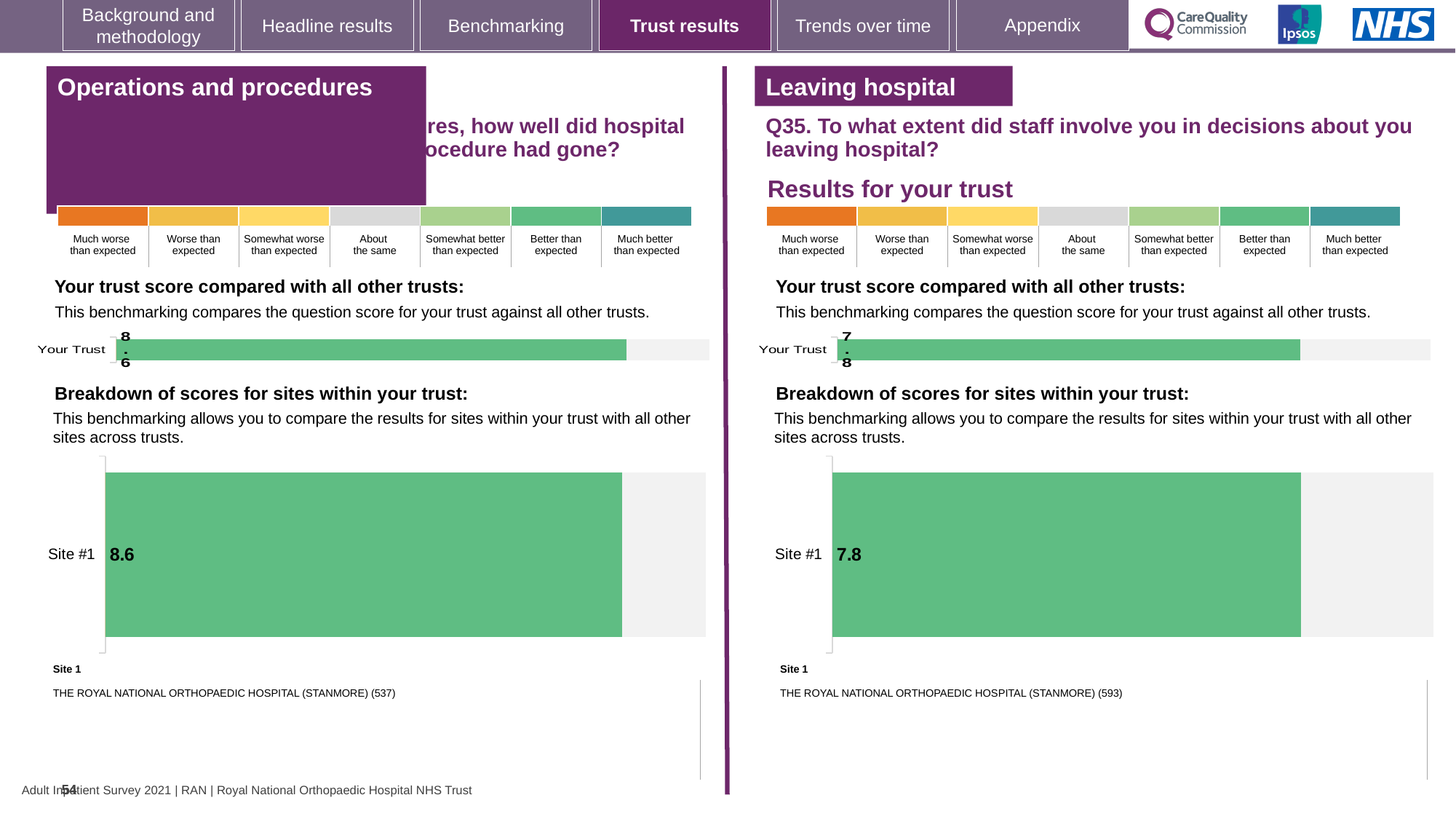
What is the difference between the Site #1 score in the Operations and procedures section and the Site #1 score in the Leaving hospital section? 0.8 What colour is the Site #1 bar in the Leaving hospital section's breakdown chart? Green In the Leaving hospital section, what is the name of Site 1 listed below the breakdown chart? THE ROYAL NATIONAL ORTHOPAEDIC HOSPITAL (STANMORE) Which Site #1 score is larger: the one in the Operations and procedures section or the one in the Leaving hospital section? Operations and procedures What kind of chart is used to show the Site #1 score in the Leaving hospital section? Bar chart How many sites are shown in the breakdown of scores chart in the Operations and procedures section? 1 In the Operations and procedures section, what is the score shown for Site #1 in the breakdown of scores for sites chart? 8.6 In the Leaving hospital section (Q35), what is the score shown for Site #1 in the breakdown of scores for sites chart? 7.8 In the Operations and procedures section, what is the value shown for Your Trust in the trust score chart? 8.6 In the Leaving hospital section (Q35), what is the value shown for Your Trust in the trust score chart? 7.8 How many sites are shown in the breakdown of scores chart in the Leaving hospital section? 1